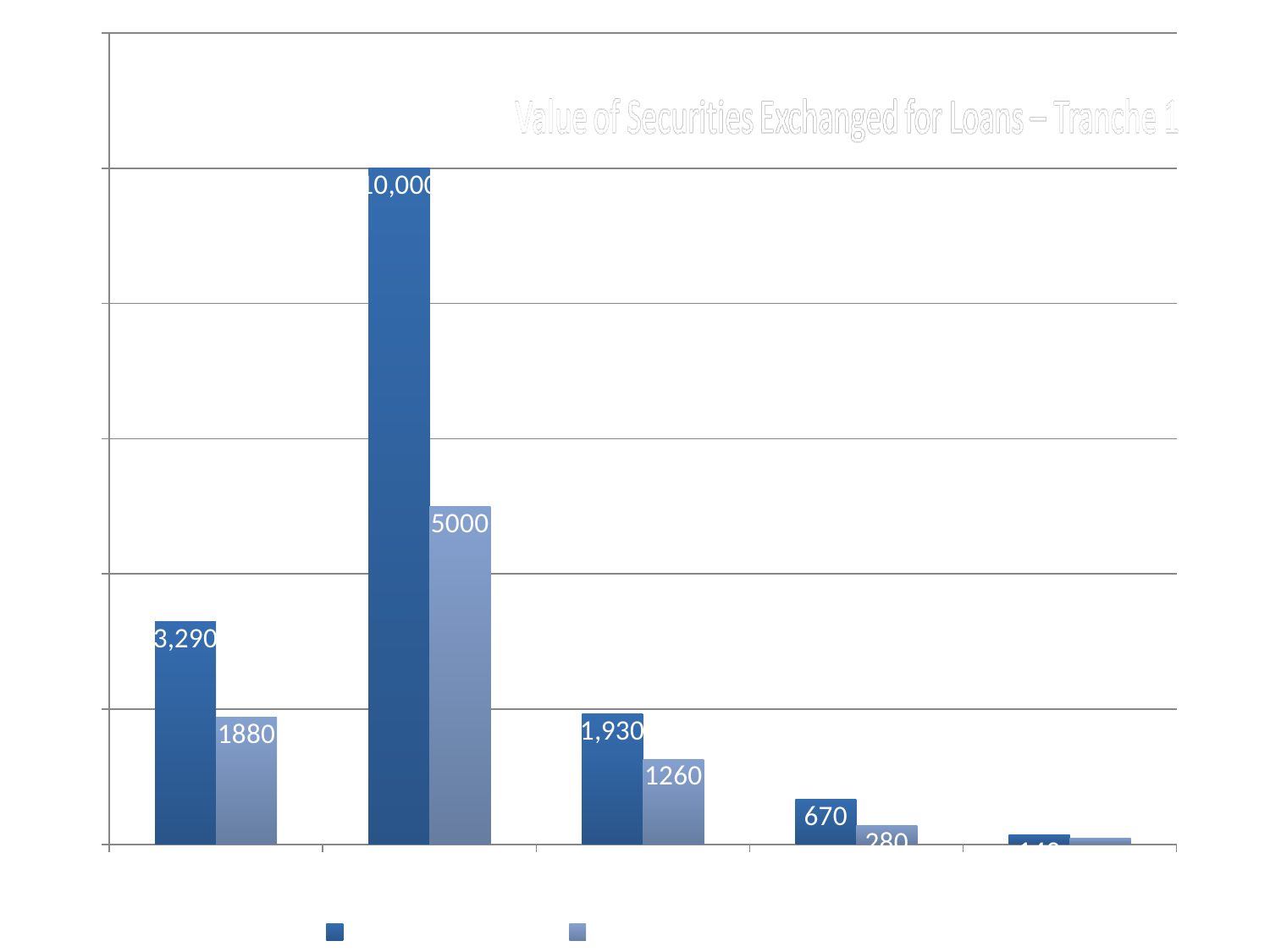
How many category groups of bars are plotted in the chart? 5 What is the value of the light blue bar in the third group? 1260 What is the value of the dark blue bar in the third group? 1,930 How many series does the legend list? 2 What is the value of the dark blue bar in the first (leftmost) group? 3,290 What is the value of the light blue bar in the second group? 5000 What is the value of the dark blue bar in the fourth group? 670 What is the value of the light blue bar in the first (leftmost) group? 1880 What is the title of the chart? Value of Securities Exchanged for Loans – Tranche 1 Which group contains the tallest bar in the chart? the second group What kind of chart is shown on the slide? bar chart What is the difference between the dark blue and light blue bars in the third group? 670